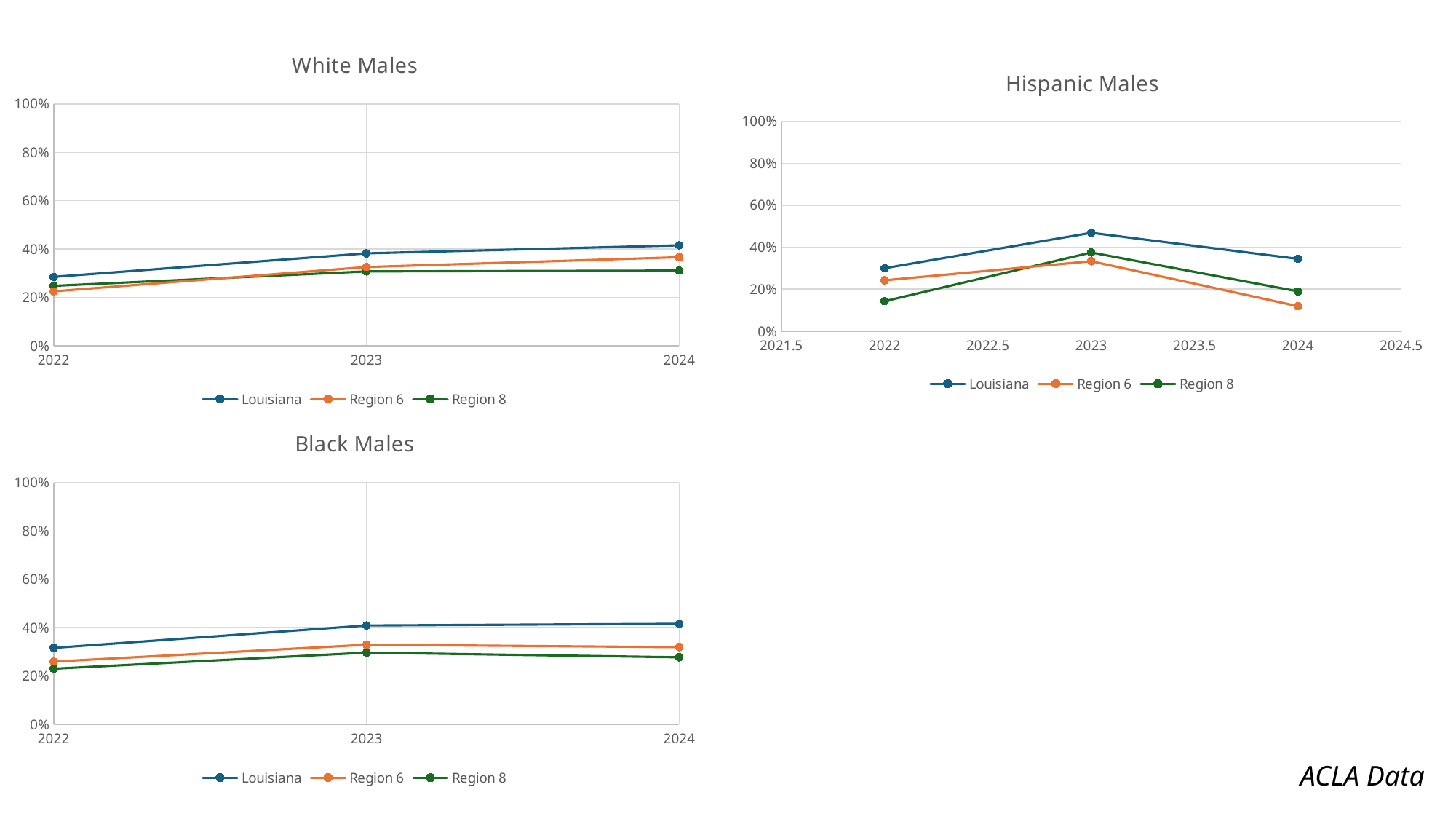
In the "Black Males" chart, which is larger in 2022: Louisiana or Region 8? Louisiana Which series is drawn in orange in the "Black Males" chart? Region 6 In the "White Males" chart, does the Louisiana line rise or fall from 2022 to 2024? rise In the "White Males" chart, which series has the highest value in 2024? Louisiana In the "Hispanic Males" chart, which series has the lowest value in 2024? Region 6 How many years are plotted on the x axis of the "Black Males" chart? 3 How many series does the legend of the "Hispanic Males" chart list? 3 In the "Hispanic Males" chart, is the Louisiana value for 2023 greater or less than 40%? greater In the "Hispanic Males" chart, in which year does the Louisiana series reach its highest value? 2023 In the "Hispanic Males" chart, is the Region 6 value for 2024 greater or less than 20%? less What kind of chart is the "White Males" chart? line chart In the "Hispanic Males" chart, does the Region 6 line rise or fall from 2023 to 2024? fall